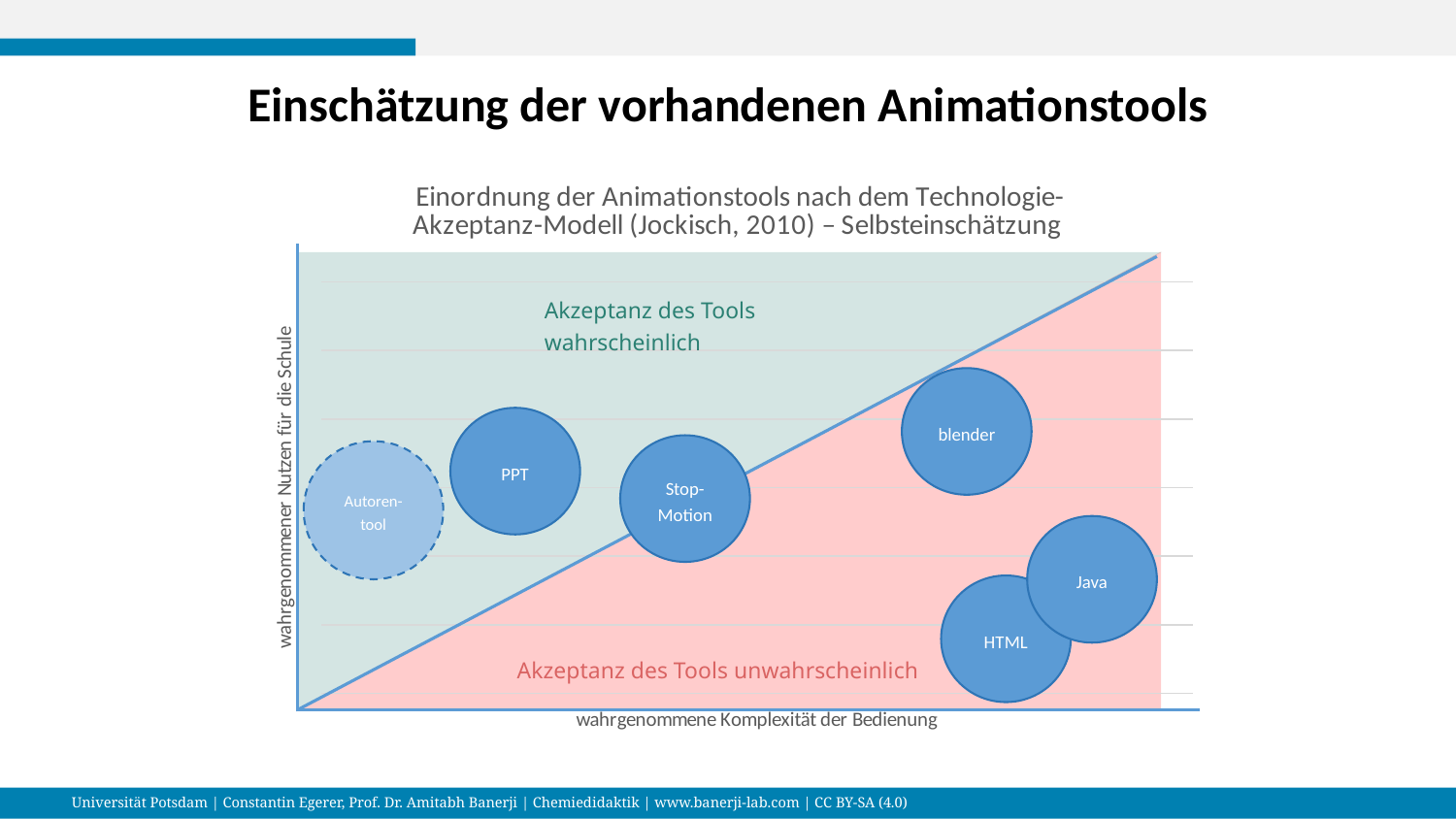
In which region of the chart is PPT located? Akzeptanz des Tools wahrscheinlich In which region of the chart is HTML located? Akzeptanz des Tools unwahrscheinlich Which tool is plotted lowest on the y axis (lowest perceived benefit for school)? HTML Which tool is plotted highest on the y axis (highest perceived benefit for school)? blender What is the label of the x axis? wahrgenommene Komplexität der Bedienung Which tool is plotted furthest to the left on the x axis (lowest perceived complexity)? Autorentool What is the title of the chart? Einordnung der Animationstools nach dem Technologie-Akzeptanz-Modell (Jockisch, 2010) – Selbsteinschätzung What kind of chart is shown on the slide? bubble chart How many animation tools are plotted as bubbles in the chart? 6 Which is plotted further to the right on the x axis, Autorentool or Java? Java Which tool is plotted furthest to the right on the x axis (highest perceived complexity)? Java Which is plotted higher on the y axis, PPT or HTML? PPT